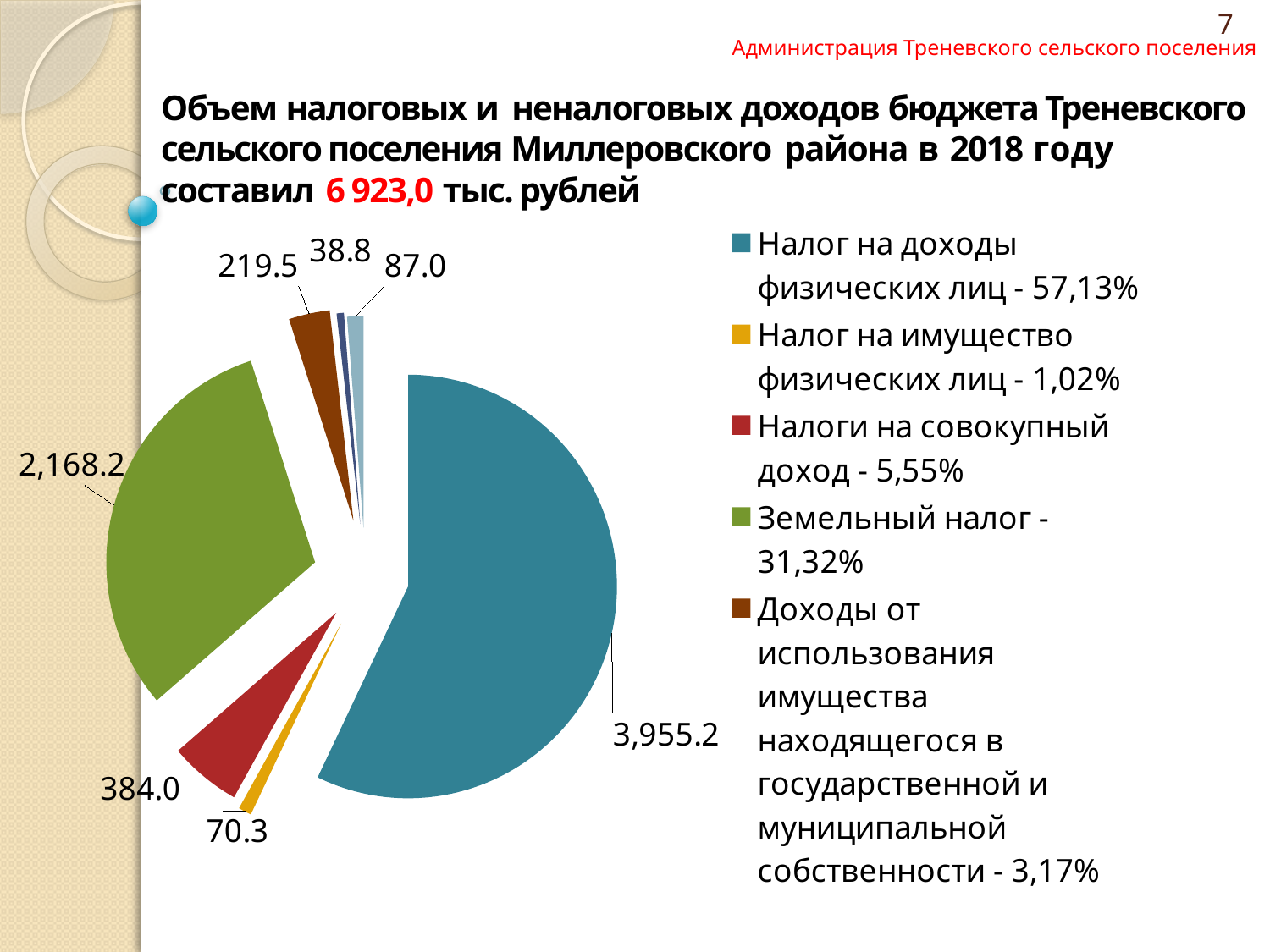
What share of the pie does Земельный налог represent, according to the legend? 31,32% What type of chart is shown on the slide? pie chart What is the value of the slice for Доходы от использования имущества находящегося в государственной и муниципальной собственности? 219.5 What colour is the slice for Налог на доходы физических лиц? blue Which category has the largest slice in the pie chart? Налог на доходы физических лиц What is the value of the slice for Налог на имущество физических лиц? 70.3 What is the value of the slice for Налог на доходы физических лиц? 3,955.2 What is the value of the slice for Земельный налог? 2,168.2 Which is larger: the slice for Налоги на совокупный доход or the slice for Доходы от использования имущества? Налоги на совокупный доход What is the difference between the values for Налог на доходы физических лиц and Земельный налог? 1,787.0 What is the value of the slice for Налоги на совокупный доход? 384.0 How many slices does the pie chart have? 7